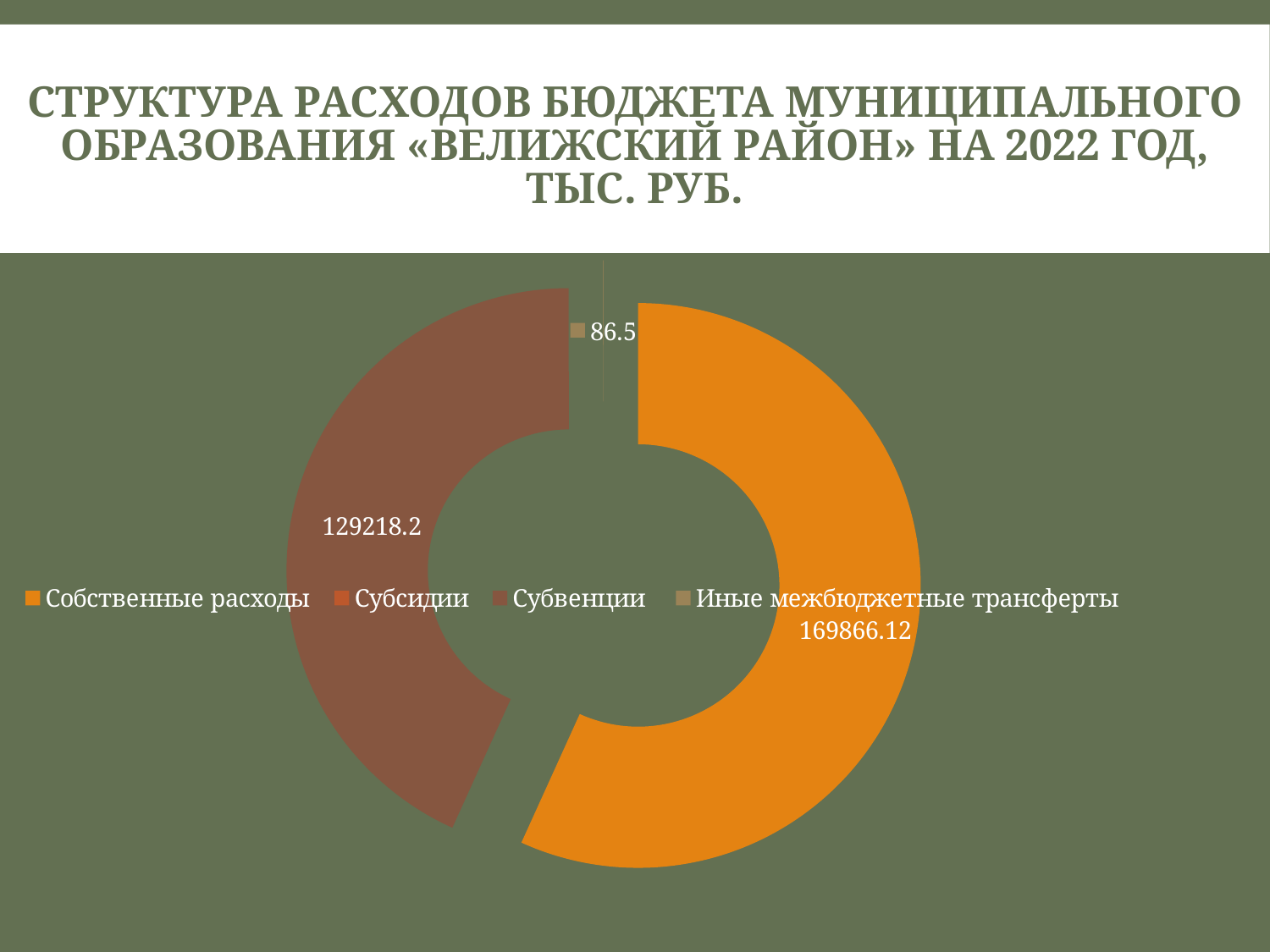
What is the value for Иные межбюджетные трансферты? 86.5 Which category has the largest value? Собственные расходы Which is larger, Субвенции or Иные межбюджетные трансферты? Субвенции In what units are the values given, according to the chart title? тыс. руб. What is the difference between the values for Собственные расходы and Субвенции? 40647.92 How many categories does the legend list? 4 What is the value for Субвенции? 129218.2 What colour is the Собственные расходы slice? Orange What kind of chart is shown on the slide? Doughnut (pie) chart What is the value for Собственные расходы? 169866.12 Which is larger, Собственные расходы or Субвенции? Собственные расходы